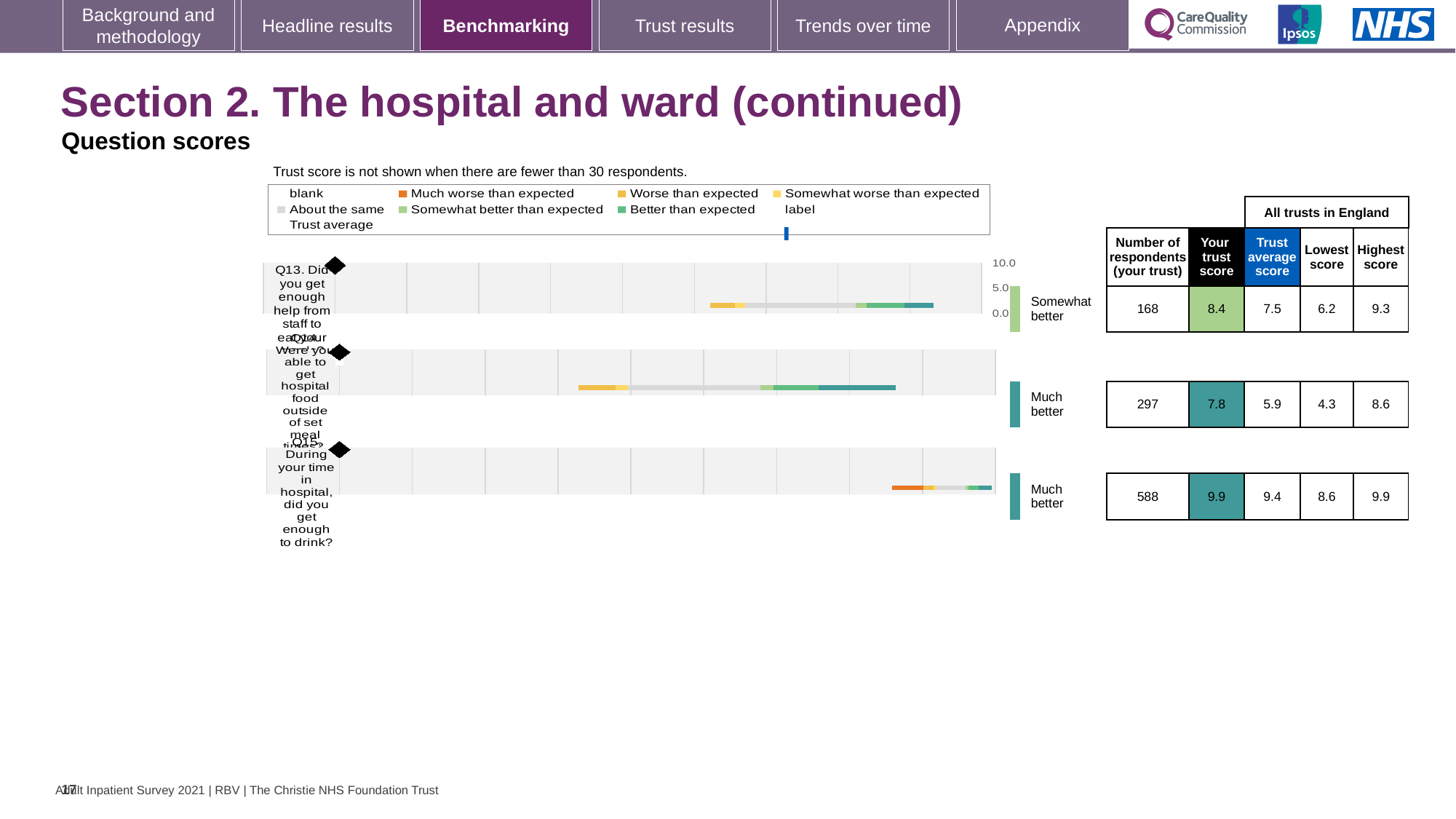
What kind of chart is used to show the benchmarking results for Q13, Q14 and Q15? Bar chart What benchmark category label is shown next to the Q13 chart? Somewhat better Which legend entry is shown in orange in the chart legend? Much worse than expected For the Q13 chart (help from staff to eat meals), what is the trust score shown in the table? 8.4 Which of the three questions (Q13, Q14, Q15) has the lowest number of respondents? Q13 How many question charts (Q13, Q14, Q15) are shown on the slide? 3 For the Q14 chart (hospital food outside of set meal times), what is the trust average score for all trusts in England? 5.9 What is the difference between the trust score and the trust average score for Q14? 1.9 Is the trust score for Q13 larger or smaller than the trust score for Q14? Larger Which of the three questions (Q13, Q14, Q15) has the highest trust score? Q15 What is the lowest score among all trusts in England for Q15? 8.6 For the Q15 chart (enough to drink), how many respondents did the trust have? 588